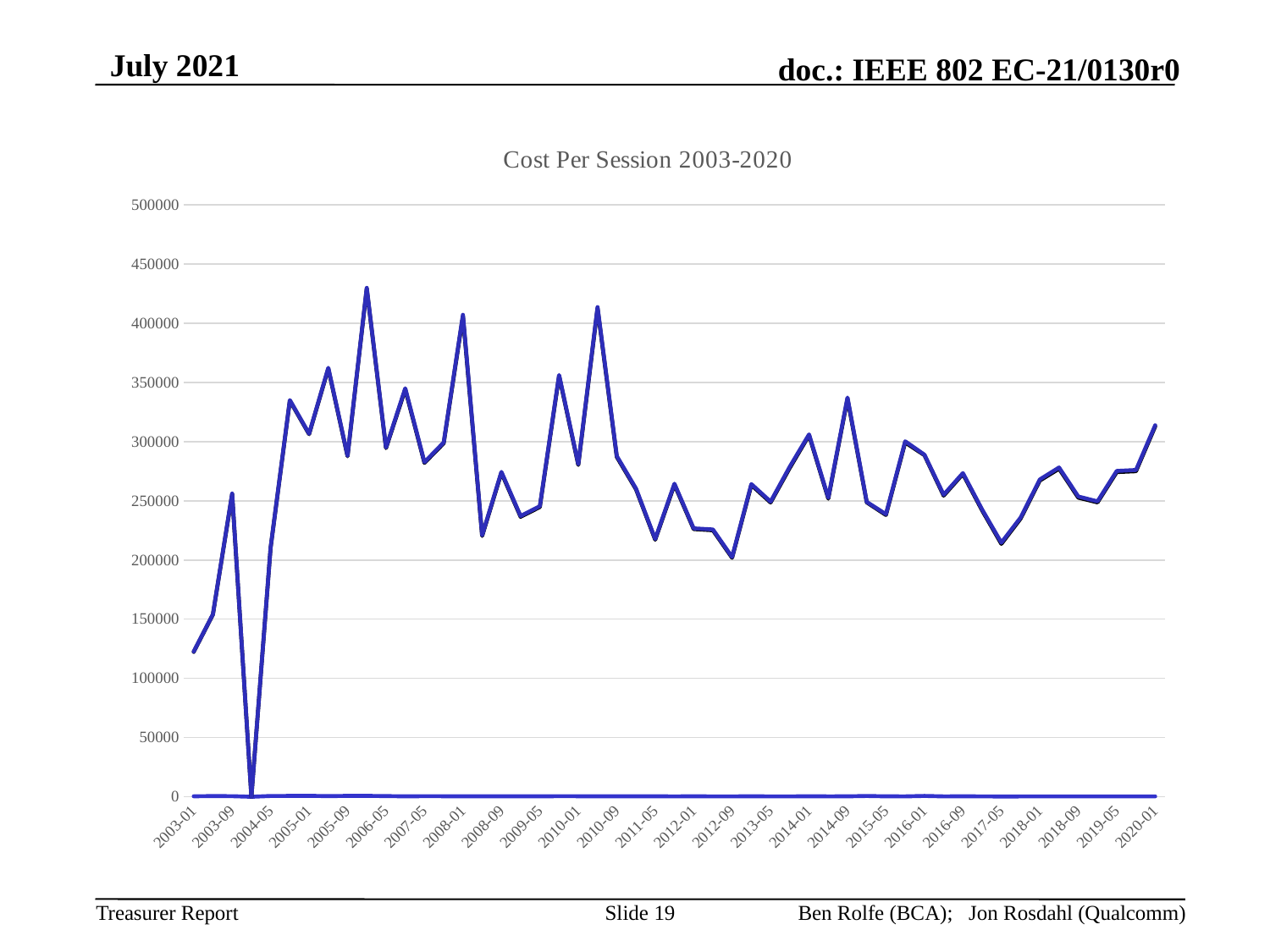
Which has the larger value, 2003-01 or 2020-01? 2020-01 What kind of chart is shown on the slide? line chart What is the title of the chart? Cost Per Session 2003-2020 Is the value for 2017-05 greater or less than 250000? less Is the value for 2014-09 greater or less than 300000? greater What is the highest value shown on the vertical axis? 500000 Is the value for 2003-01 greater or less than 150000? less Does the line rise or fall between 2003-01 and 2003-09? rise Which has the larger value, 2014-09 or 2017-05? 2014-09